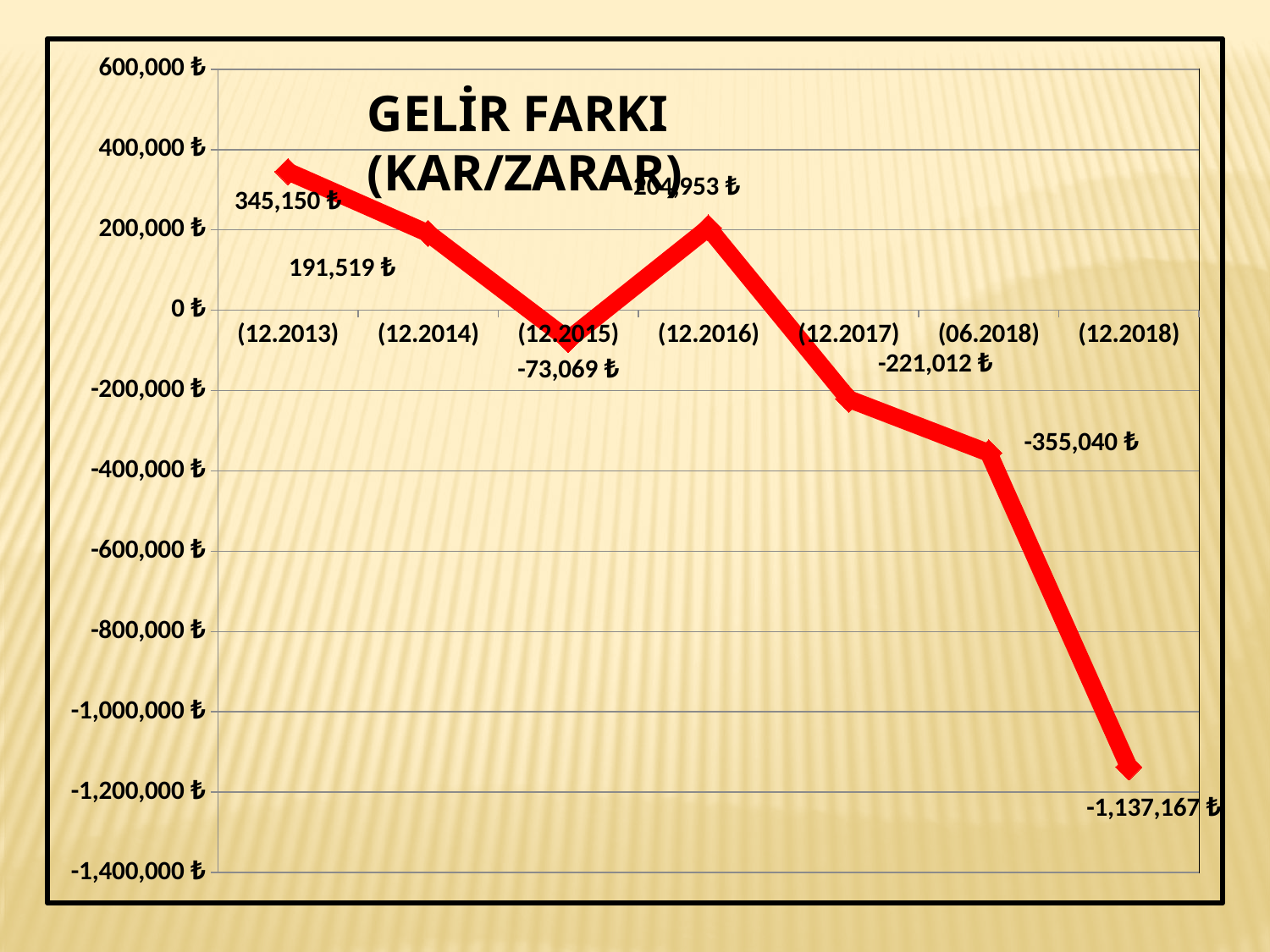
Which period has the lowest value? (12.2018) What kind of chart is shown? Line chart What is the value for (12.2017)? -221,012 ₺ What is the value for (12.2018)? -1,137,167 ₺ How many periods are plotted on the x axis? 7 Which is larger, the value for (12.2017) or the value for (06.2018)? (12.2017) What is the difference between the values for (12.2013) and (12.2014)? 153,631 ₺ What is the value for (06.2018)? -355,040 ₺ What is the value for (12.2013)? 345,150 ₺ Which period has the highest value? (12.2013) What is the value for (12.2015)? -73,069 ₺ What is the value for (12.2014)? 191,519 ₺